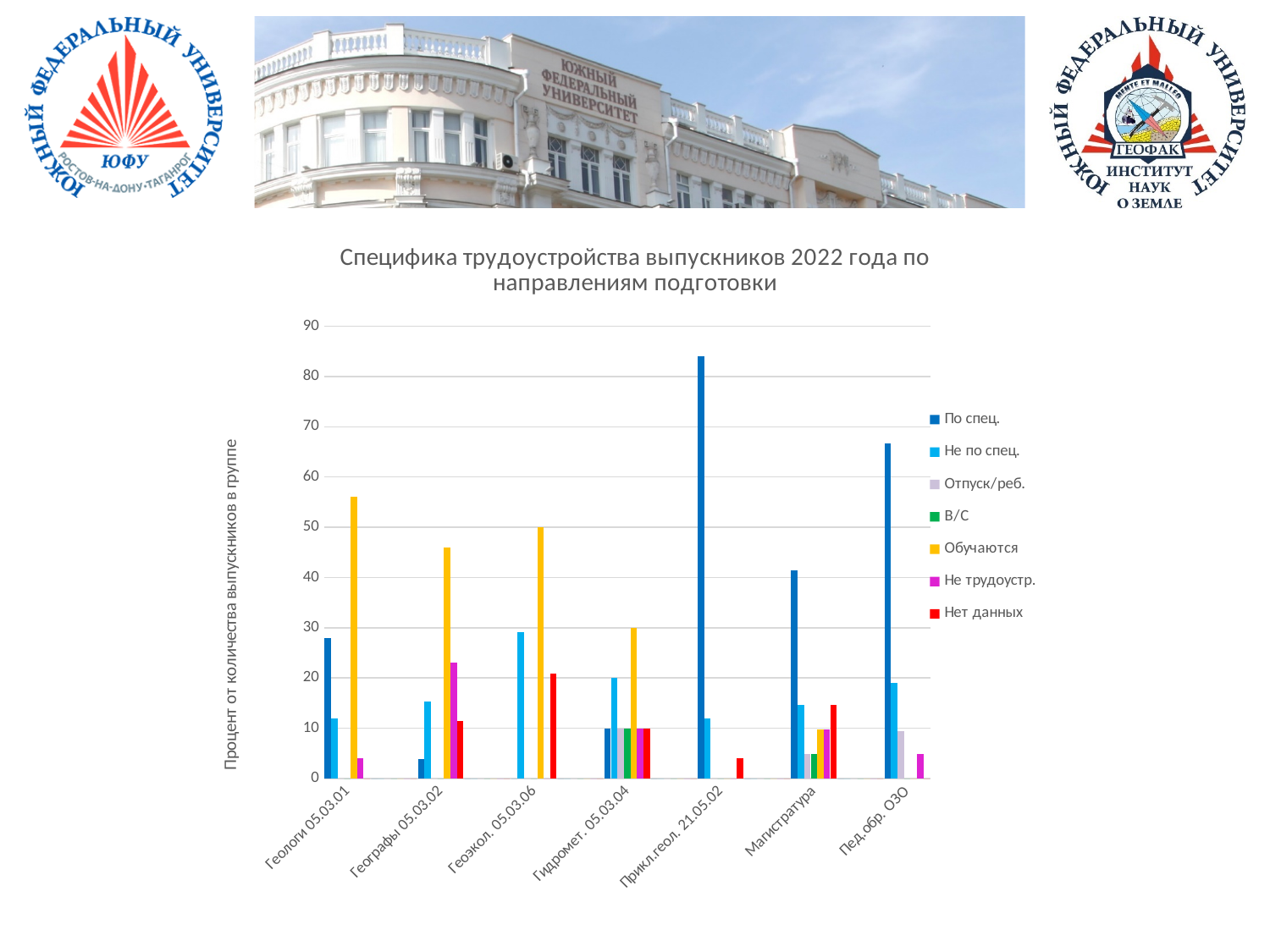
What kind of chart is shown on the slide? bar chart Is the value of "Не трудоустр." for Географы 05.03.02 greater or less than 20? greater Is the value of "Обучаются" for Геологи 05.03.01 greater or less than 50? greater What is the label of the vertical axis? Процент от количества выпускников в группе Which is larger: the "Не по спец." value for Геоэкол. 05.03.06 or for Гидромет. 05.03.04? Геоэкол. 05.03.06 How many categories (directions of training) are shown on the x axis? 7 Is the value of "По спец." for Прикл.геол. 21.05.02 greater or less than 80? greater Which category has the highest value for the series "Обучаются"? Геологи 05.03.01 What is the title of the chart? Специфика трудоустройства выпускников 2022 года по направлениям подготовки Which category has the highest value for the series "По спец."? Прикл.геол. 21.05.02 How many series does the legend list? 7